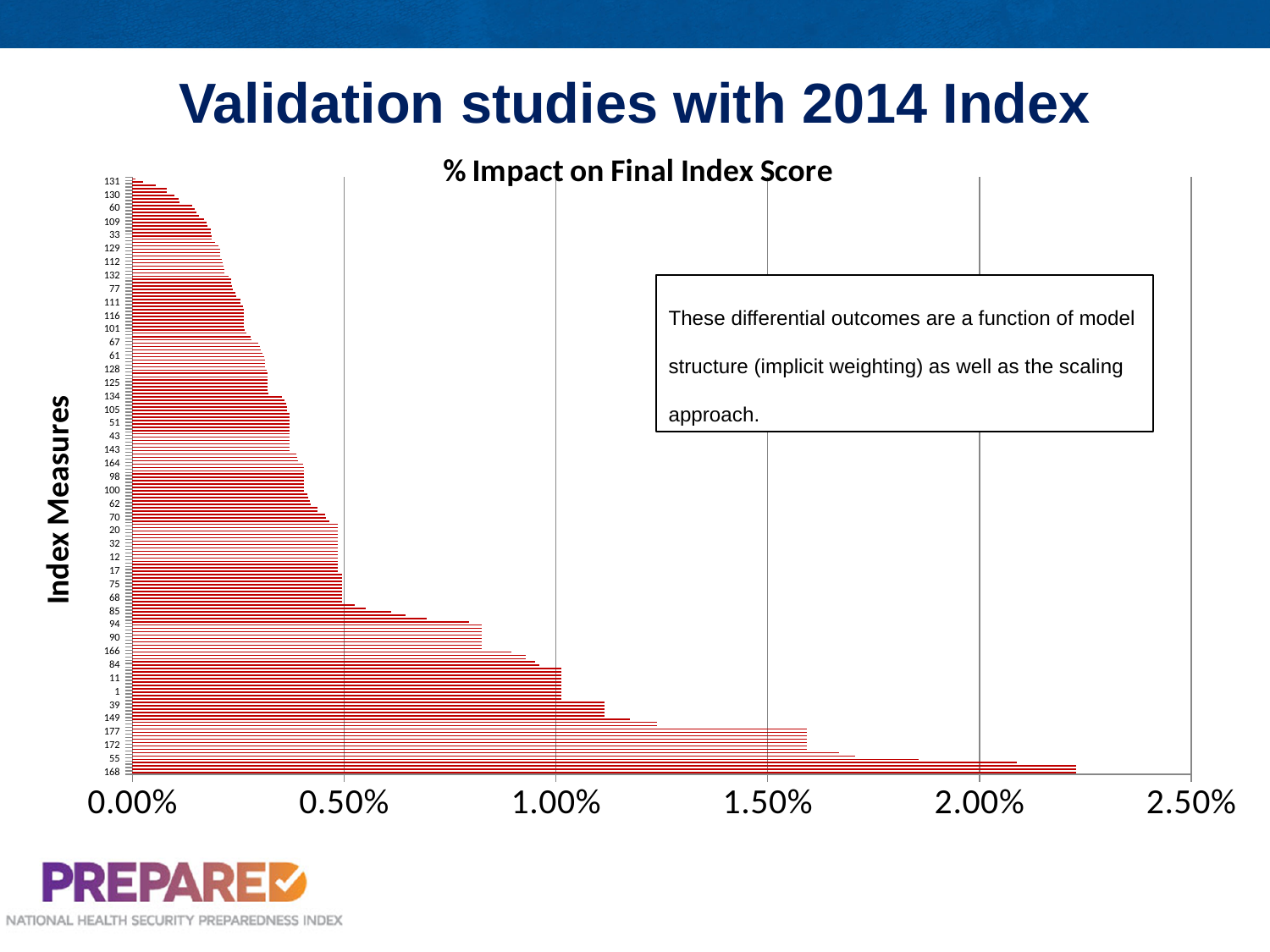
Is the value for index measure 149 greater or less than 1.00%? greater What is the title of the chart? % Impact on Final Index Score Is the value for index measure 131 greater or less than 0.50%? less Is the value for index measure 90 greater or less than 1.00%? less Do the bar lengths increase or decrease going from the top of the chart to the bottom? increase What kind of chart is shown on the slide? bar chart Which has a larger % impact on the final index score, index measure 168 or index measure 131? 168 Which index measure has the highest % impact on the final index score? 168 What is the label on the vertical axis of the chart? Index Measures